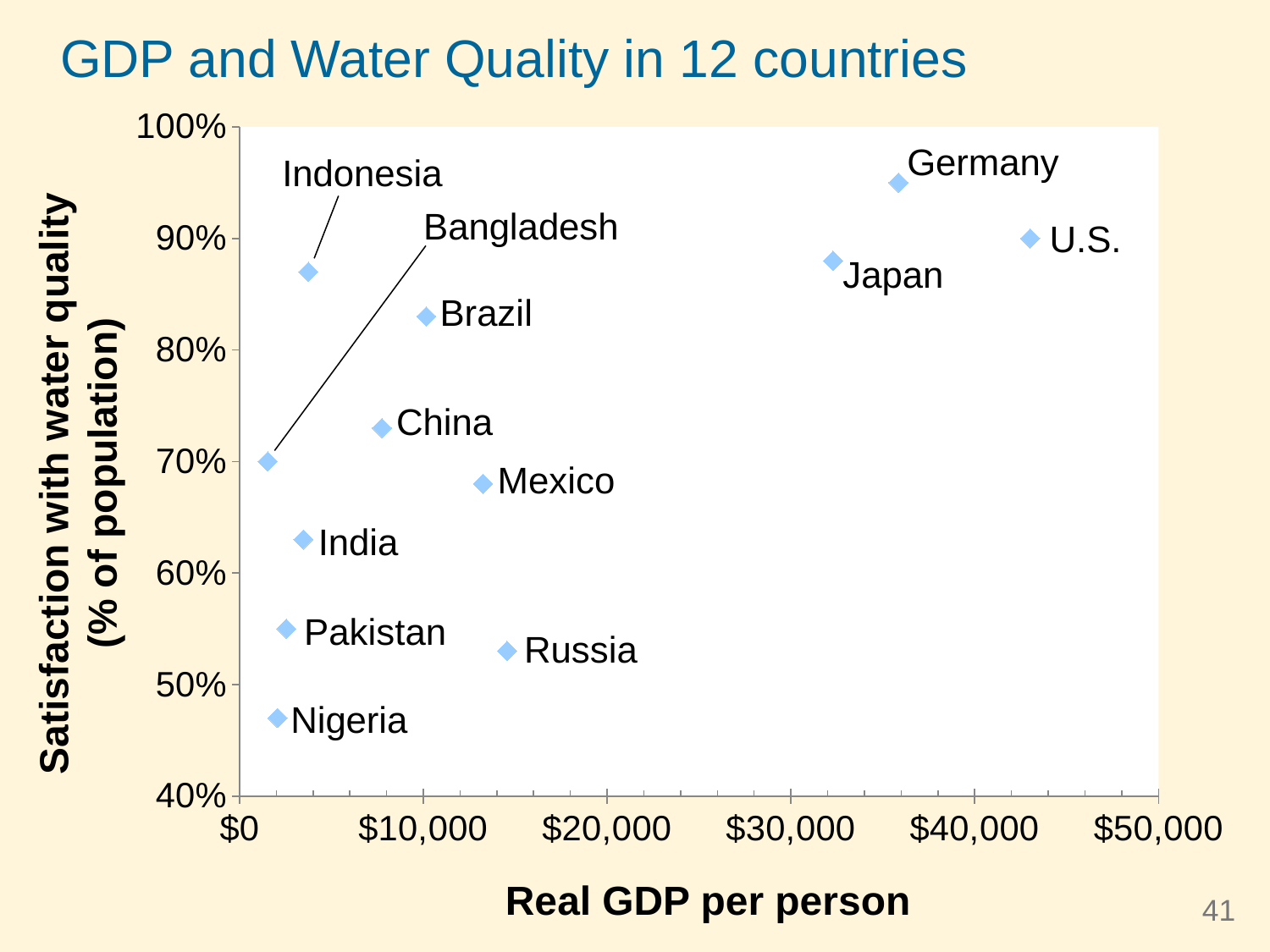
Which has higher satisfaction with water quality, Brazil or China? Brazil Which country has the lowest satisfaction with water quality? Nigeria Is the real GDP per person for Japan greater or less than $30,000? greater What is the satisfaction with water quality for the U.S.? 90% Is the satisfaction with water quality for Nigeria greater or less than 50%? less How many countries are plotted on the chart? 12 What is the title of the horizontal axis? Real GDP per person Does satisfaction with water quality generally rise or fall as real GDP per person increases? rise Is the satisfaction with water quality for Russia greater or less than 60%? less Which country has the highest satisfaction with water quality? Germany What is the satisfaction with water quality for Bangladesh? 70% What kind of chart is shown on the slide? scatter chart